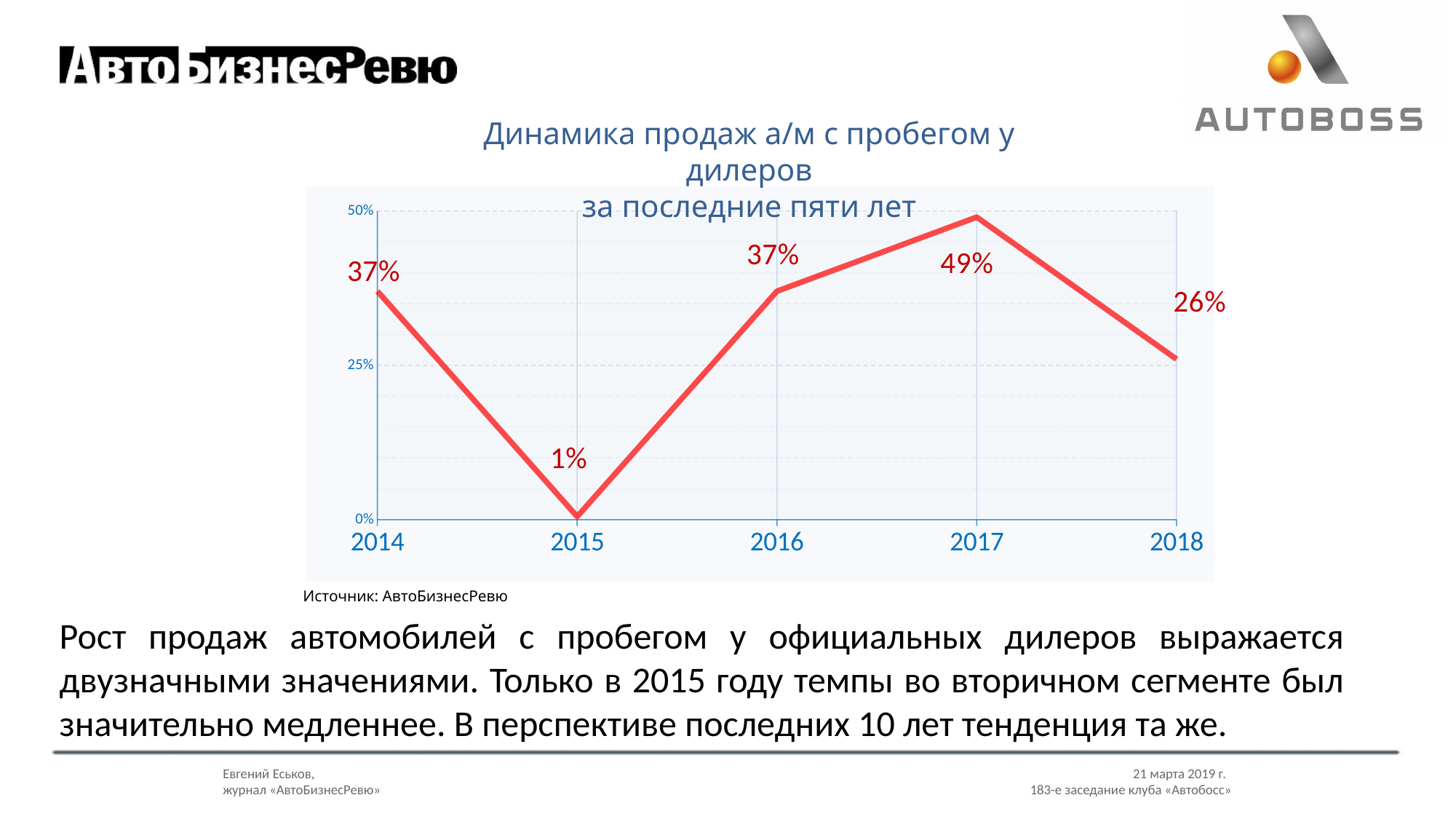
What is the value for 2017? 49% Which year has the lowest value? 2015 What is the value for 2015? 1% Do the values rise or fall from 2015 to 2017? rise What is the difference between the values for 2017 and 2018? 23% What is the value for 2014? 37% How many years are plotted on the chart? 5 Is the value for 2017 greater or less than 25%? greater Which is larger, the value for 2016 or the value for 2018? 2016 What kind of chart is shown on the slide? line chart Which year has the highest value? 2017 What is the value for 2018? 26%